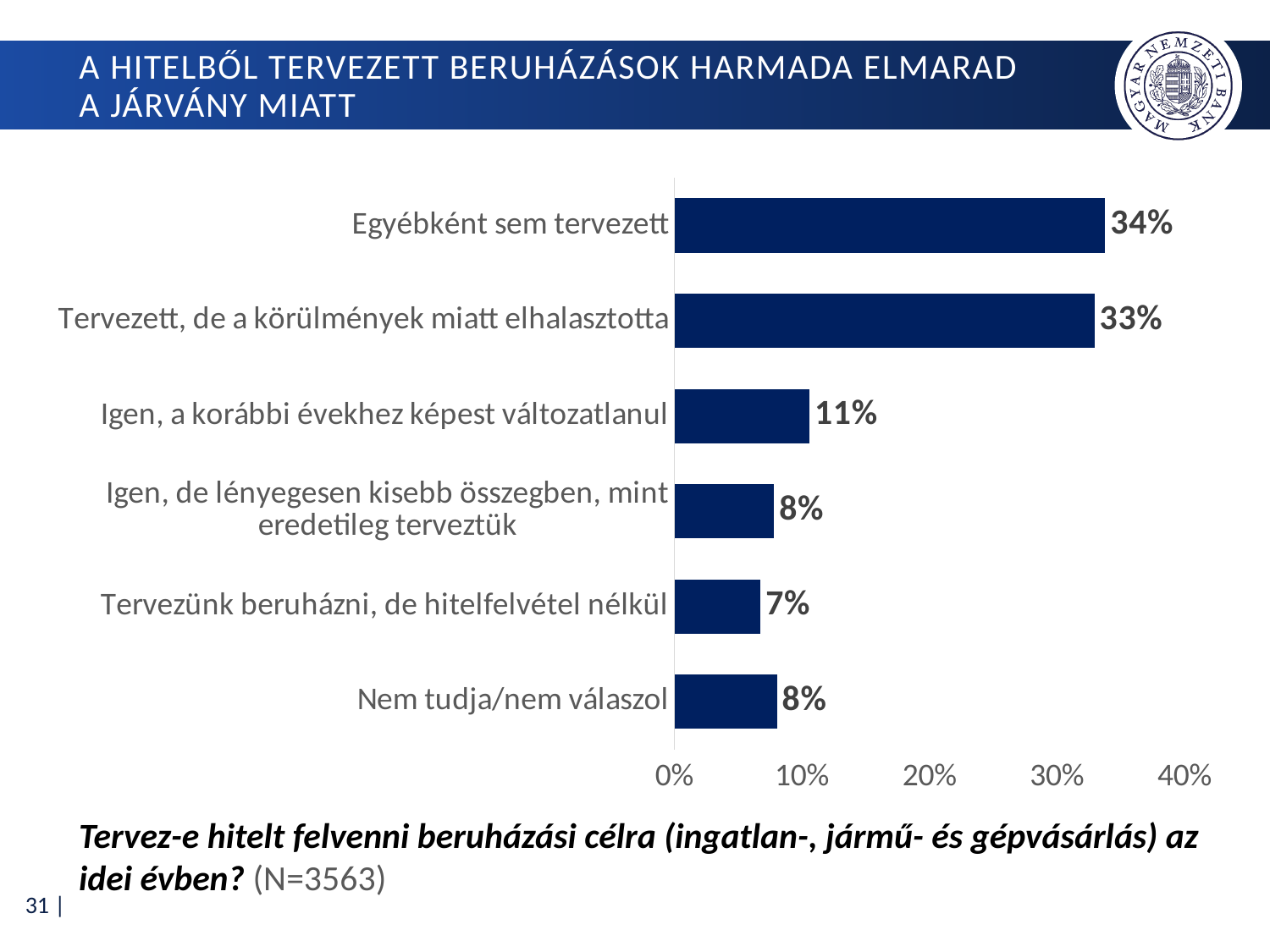
What is the value for "Nem tudja/nem válaszol"? 8% Which category has the lowest value? Tervezünk beruházni, de hitelfelvétel nélkül Which is larger: the value for "Igen, a korábbi évekhez képest változatlanul" or the value for "Nem tudja/nem válaszol"? Igen, a korábbi évekhez képest változatlanul What is the value for "Tervezünk beruházni, de hitelfelvétel nélkül"? 7% Which category has the highest value? Egyébként sem tervezett Is the value for "Tervezett, de a körülmények miatt elhalasztotta" greater or less than 30%? greater What is the value for "Tervezett, de a körülmények miatt elhalasztotta"? 33% How many categories are shown in the chart? 6 What is the value for "Egyébként sem tervezett"? 34% What kind of chart is shown on the slide? bar chart What is the value for "Igen, a korábbi évekhez képest változatlanul"? 11% What is the difference between the values for "Egyébként sem tervezett" and "Igen, a korábbi évekhez képest változatlanul"? 23%